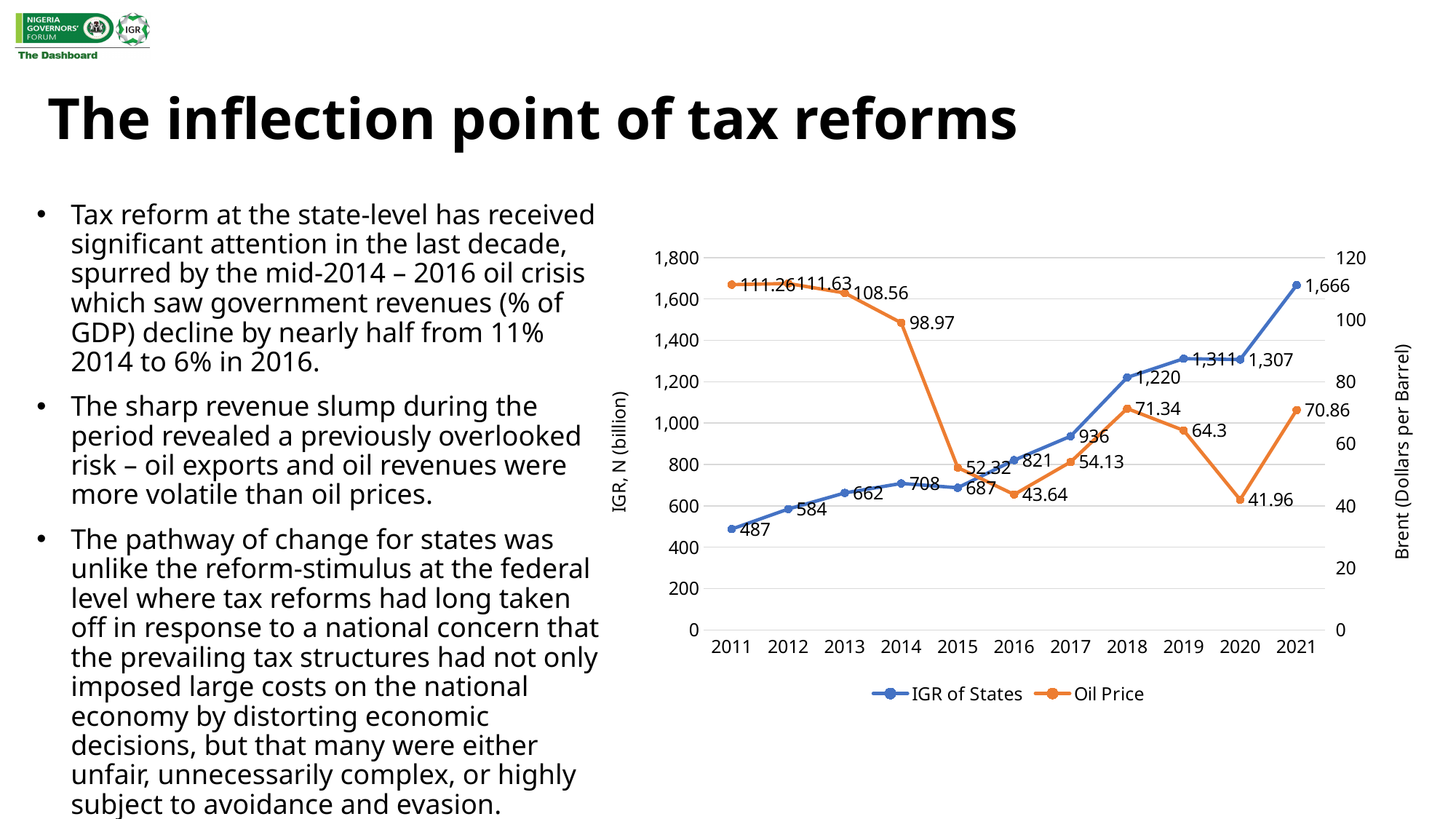
What is the Oil Price value for 2016? 43.64 What kind of chart is shown on the slide? line chart How many series does the legend list? 2 What is the difference between the IGR of States in 2021 and in 2020? 359 In which year is the Oil Price lowest? 2020 What is the label of the right-hand vertical axis? Brent (Dollars per Barrel) How many years are plotted on the x axis? 11 Does the Oil Price rise or fall from 2011 to 2016? fall What is the IGR of States value for 2018? 1,220 In which year is the IGR of States highest? 2021 Which is larger, the Oil Price in 2018 or in 2019? 2018 What is the IGR of States value for 2011? 487